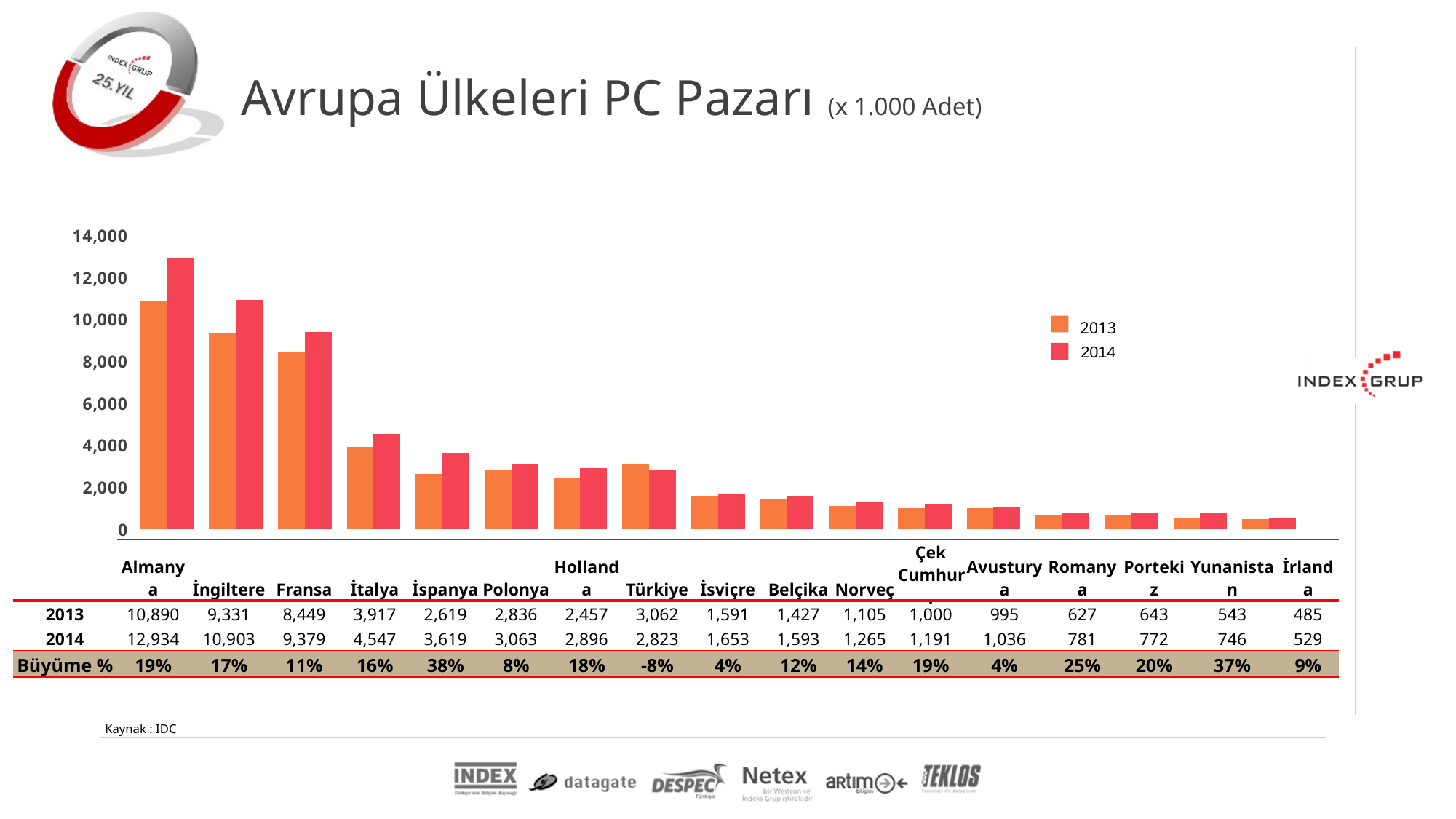
Which country has the only negative Büyüme % value? Türkiye How many countries are shown on the chart? 17 What is the 2013 value for Türkiye? 3,062 What is the difference between the 2014 and 2013 values for Almanya? 2,044 For Türkiye, which is larger: the 2013 value or the 2014 value? 2013 Which country has the highest 2014 value? Almanya How many series does the legend list? 2 Which country has the lowest 2014 value? İrlanda What is the Büyüme % value for İspanya? 38% What is the 2014 value for Almanya? 12,934 Is the 2014 value for İtalya greater or less than 4,000? greater What kind of chart is shown on the slide? bar chart